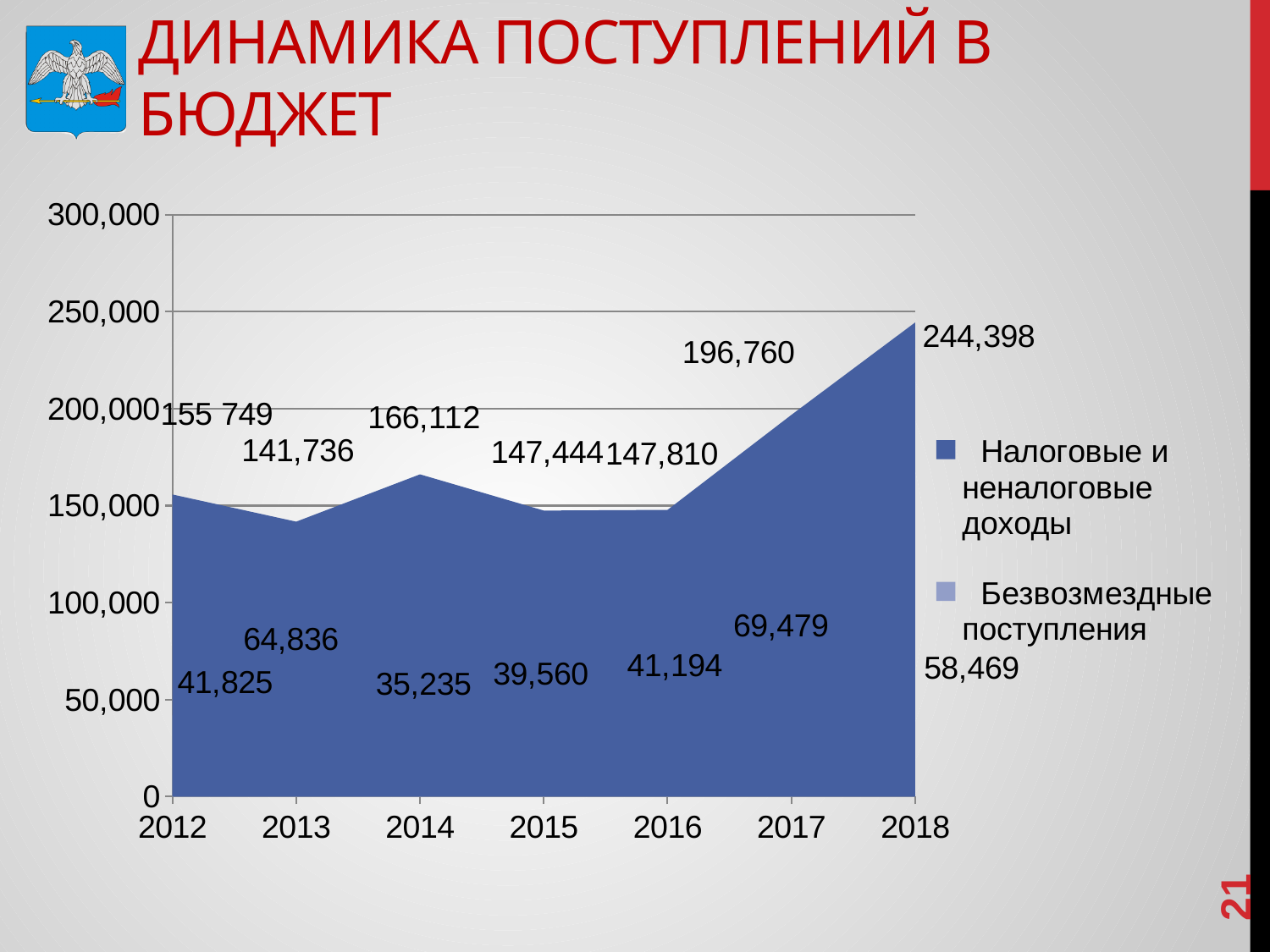
What is the difference between Налоговые и неналоговые доходы in 2018 and in 2017? 47,638 How many series does the legend list? 2 What is the value of Налоговые и неналоговые доходы in 2014? 166,112 What is the value of Безвозмездные поступления in 2017? 69,479 What is the value of Безвозмездные поступления in 2013? 64,836 What kind of chart is shown on the slide? area chart In which year is Налоговые и неналоговые доходы the lowest? 2013 Which is larger: Безвозмездные поступления in 2012 or in 2016? 2012 In which year is Безвозмездные поступления the lowest? 2014 In which year is Безвозмездные поступления the highest? 2017 What is the value of Налоговые и неналоговые доходы in 2018? 244,398 How many years are shown on the x axis? 7